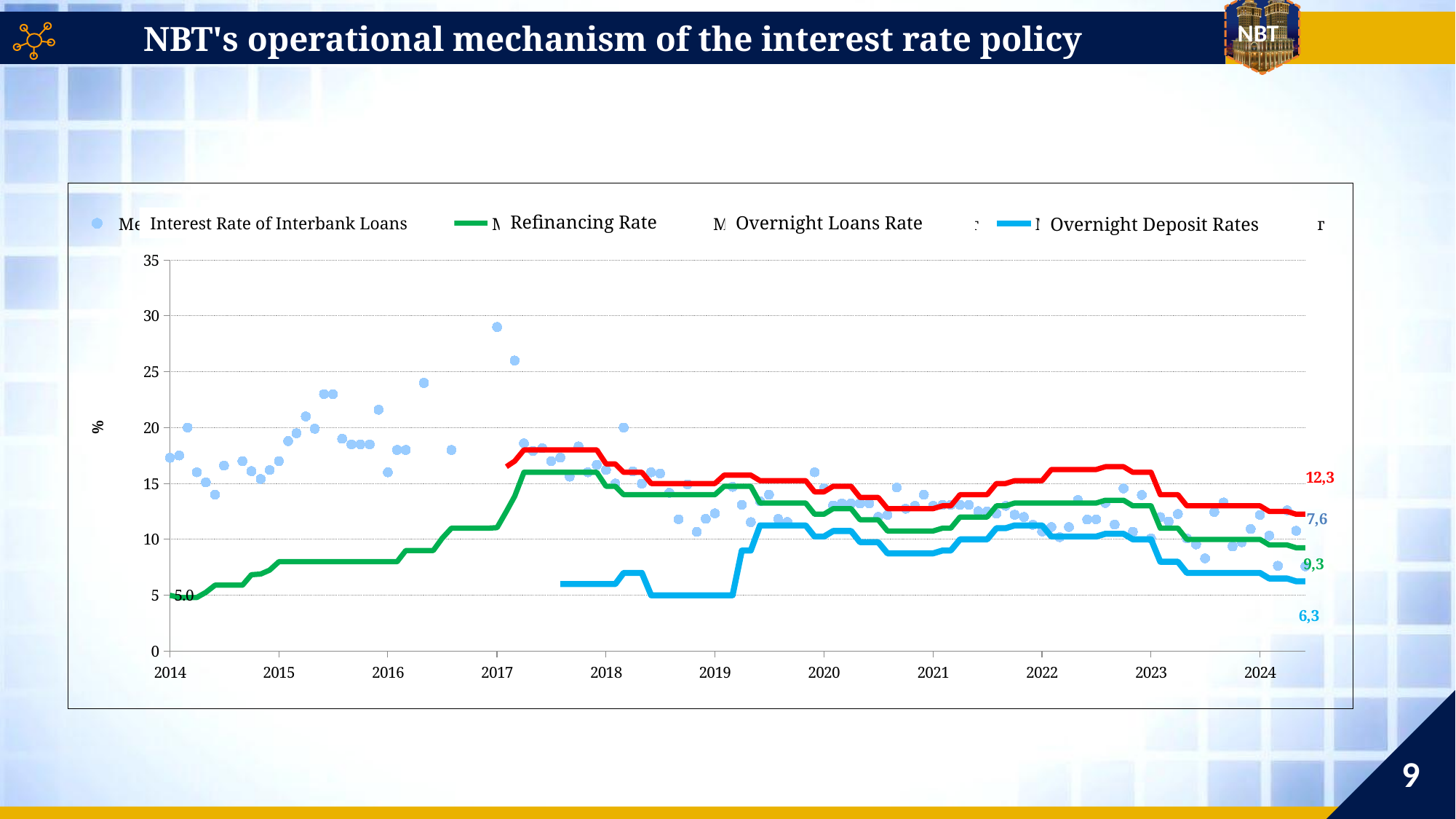
What is the latest labelled value of the Refinancing Rate at the right end of the chart? 9,3 What kind of chart is shown on the slide? line chart At the right end of the chart, which is higher: the Overnight Loans Rate or the Refinancing Rate? Overnight Loans Rate What is the difference between the latest labelled Overnight Loans Rate (12,3) and the latest labelled Overnight Deposit Rates (6,3)? 6,0 What is the difference between the latest labelled Overnight Loans Rate (12,3) and the latest labelled Refinancing Rate (9,3)? 3,0 What value is labelled on the Refinancing Rate line at the start of 2014? 5.0 What is the latest labelled value of the Overnight Deposit Rates at the right end of the chart? 6,3 What is the latest labelled value of the Overnight Loans Rate at the right end of the chart? 12,3 How many series does the chart legend list? 4 Does the Overnight Deposit Rates line rise or fall between 2023 and 2024? fall Is the Overnight Deposit Rates value at the start of 2019 greater or less than 10? less What colour is the Refinancing Rate line in the chart? green